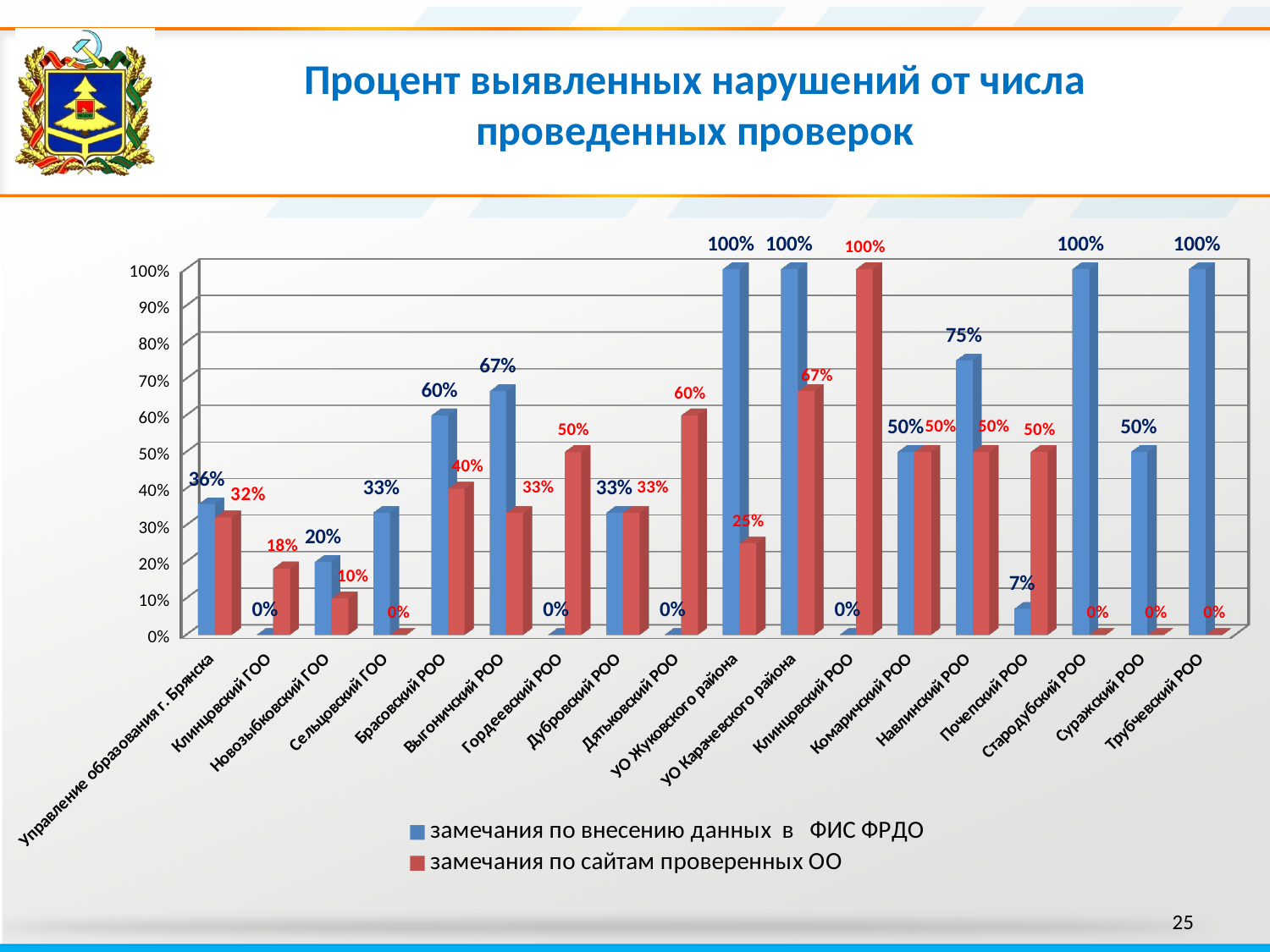
Which category has the highest value for 'замечания по сайтам проверенных ОО'? Клинцовский РОО What is the value of 'замечания по внесению данных в ФИС ФРДО' for Почепский РОО? 7% What type of chart is shown on the slide? Bar chart What is the title of the chart? Процент выявленных нарушений от числа проведенных проверок What is the value of 'замечания по внесению данных в ФИС ФРДО' for Выгоничский РОО? 67% How many categories are shown on the x axis? 18 What is the difference between the two series for Навлинский РОО? 25% What is the difference between 'замечания по внесению данных в ФИС ФРДО' and 'замечания по сайтам проверенных ОО' for УО Жуковского района? 75% Which is larger for Брасовский РОО: 'замечания по внесению данных в ФИС ФРДО' or 'замечания по сайтам проверенных ОО'? замечания по внесению данных в ФИС ФРДО How many series does the legend list? 2 What is the value of 'замечания по сайтам проверенных ОО' for Управление образования г. Брянска? 32% What is the value of 'замечания по сайтам проверенных ОО' for Дятьковский РОО? 60%